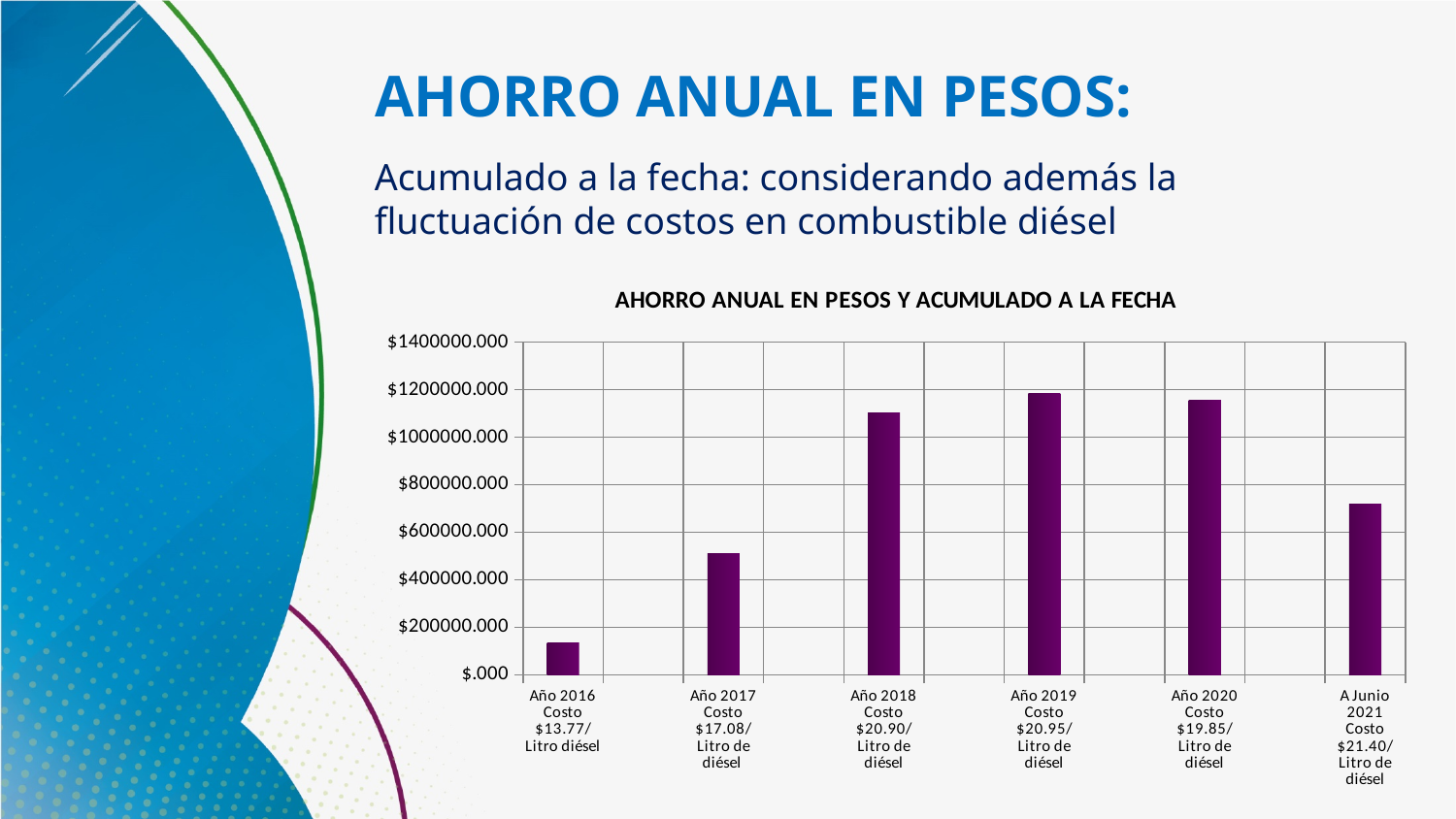
Is the value for Año 2016 greater or less than $200000.000? less Which is larger, the value for Año 2018 or the value for Año 2017? Año 2018 Which is larger, the value for A Junio 2021 or the value for Año 2016? A Junio 2021 Do the values rise or fall from Año 2016 to Año 2019? rise Which category has the lowest value in the chart? Año 2016 Is the value for Año 2018 greater or less than $1000000.000? greater What diesel cost per litre is shown in the axis label for Año 2018? $20.90/Litro de diésel What kind of chart is shown on the slide? bar chart How many bars (categories) does the chart show? 6 Is the value for Año 2017 greater or less than $400000.000? greater What is the title of the chart? AHORRO ANUAL EN PESOS Y ACUMULADO A LA FECHA